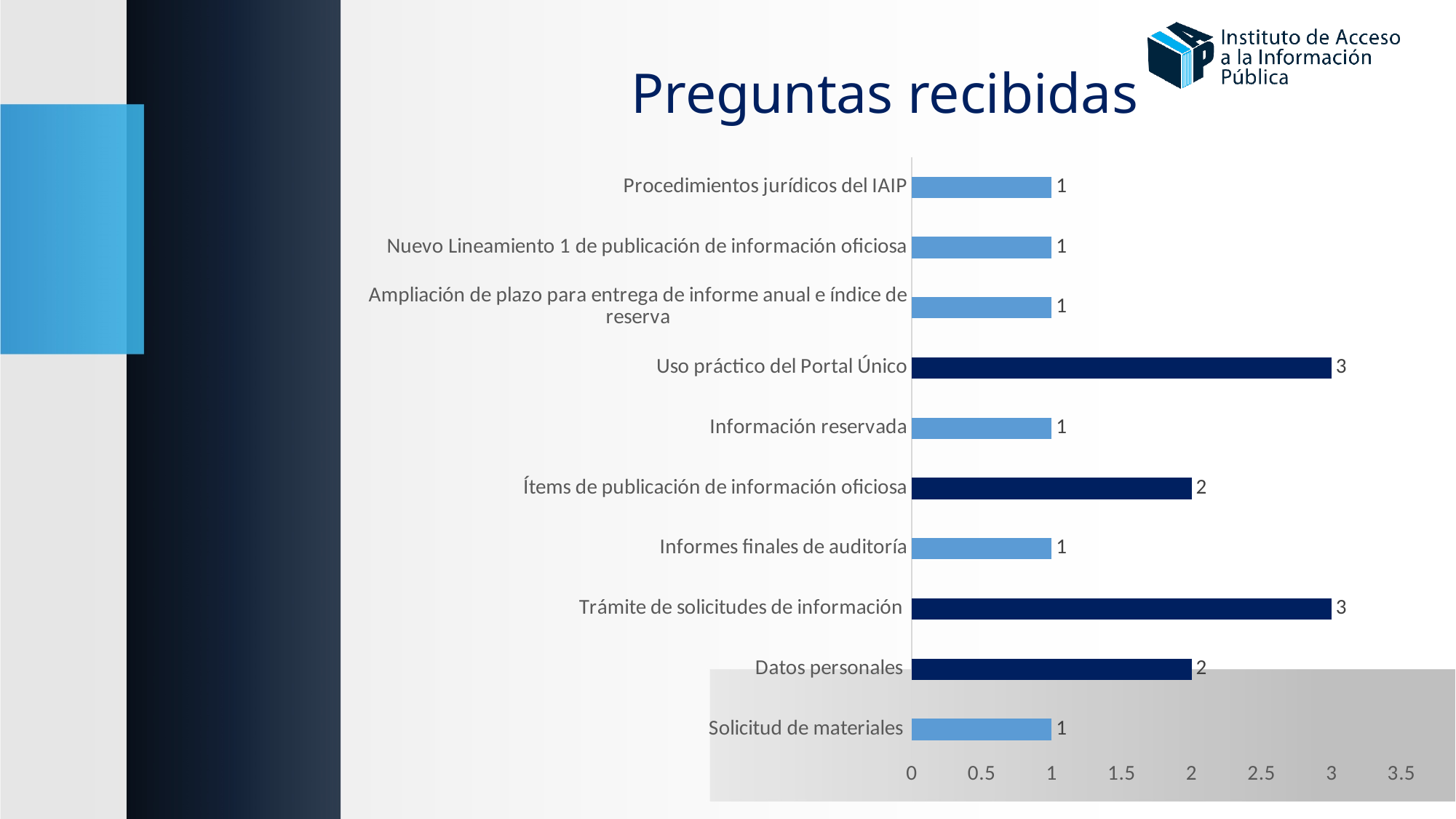
What is the value for Uso práctico del Portal Único? 3 What kind of chart is shown on the slide? Bar chart What is the value for Datos personales? 2 How many categories are shown in the chart? 10 What is the value for Trámite de solicitudes de información? 3 Which is larger, the value for Ítems de publicación de información oficiosa or the value for Procedimientos jurídicos del IAIP? Ítems de publicación de información oficiosa What is the value for Solicitud de materiales? 1 Which is larger, the value for Trámite de solicitudes de información or the value for Informes finales de auditoría? Trámite de solicitudes de información What is the difference between the values for Datos personales and Solicitud de materiales? 1 What is the value for Ítems de publicación de información oficiosa? 2 What is the title of the chart? Preguntas recibidas What is the difference between the values for Uso práctico del Portal Único and Información reservada? 2